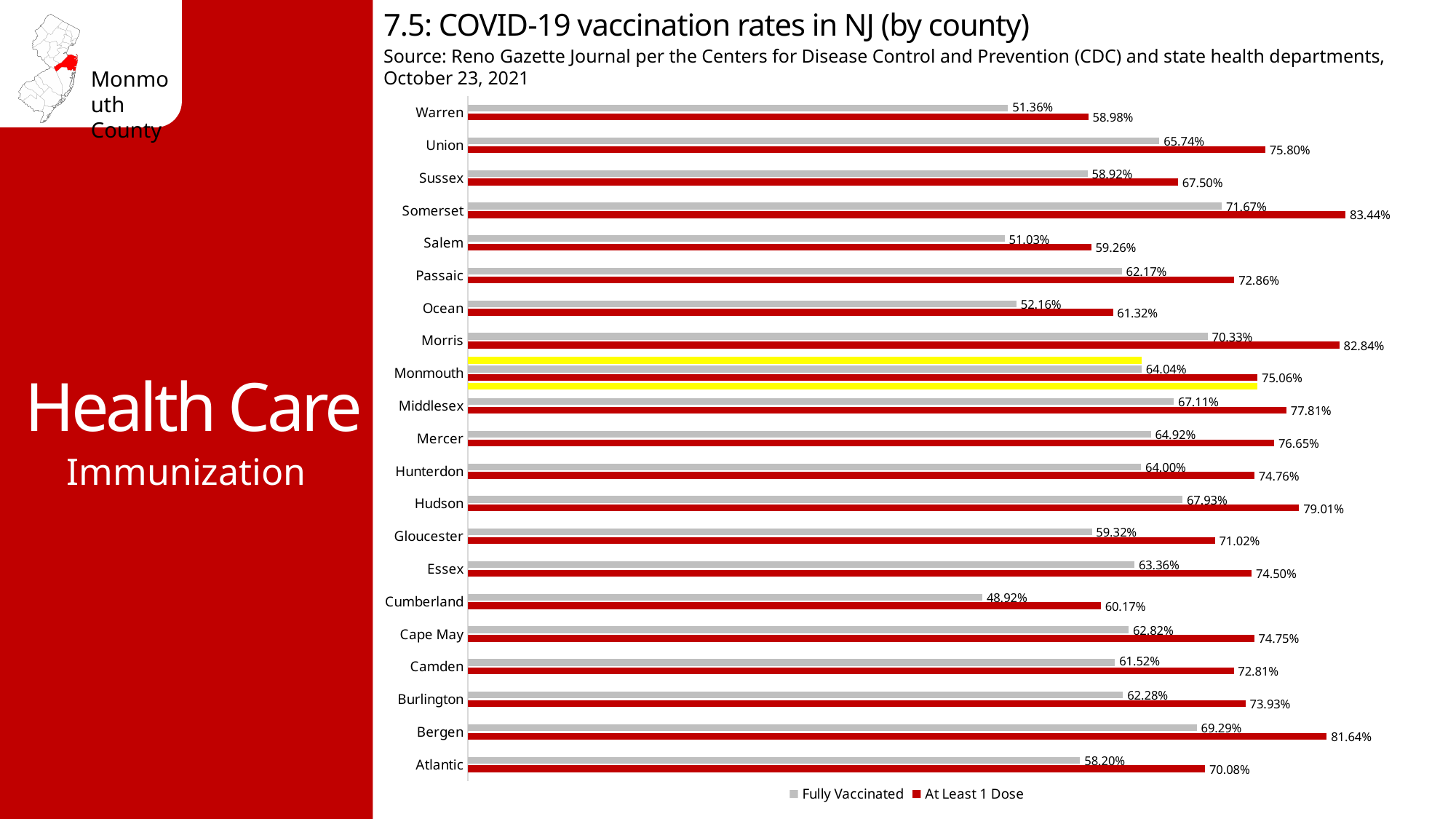
Which county has the lowest Fully Vaccinated rate? Cumberland What is the At Least 1 Dose rate for Cumberland County? 60.17% What type of chart is shown on the slide? Bar chart Which county has the lowest At Least 1 Dose rate? Warren What is the At Least 1 Dose rate for Somerset County? 83.44% Which county has the highest Fully Vaccinated rate? Somerset Which county has a higher Fully Vaccinated rate, Bergen or Hudson? Bergen What is the Fully Vaccinated rate for Monmouth County? 64.04% What is the difference between the At Least 1 Dose rate and the Fully Vaccinated rate for Monmouth County? 11.02% Which county's bars are highlighted in yellow on the chart? Monmouth How many series does the legend list? 2 How many counties are shown in the chart? 21